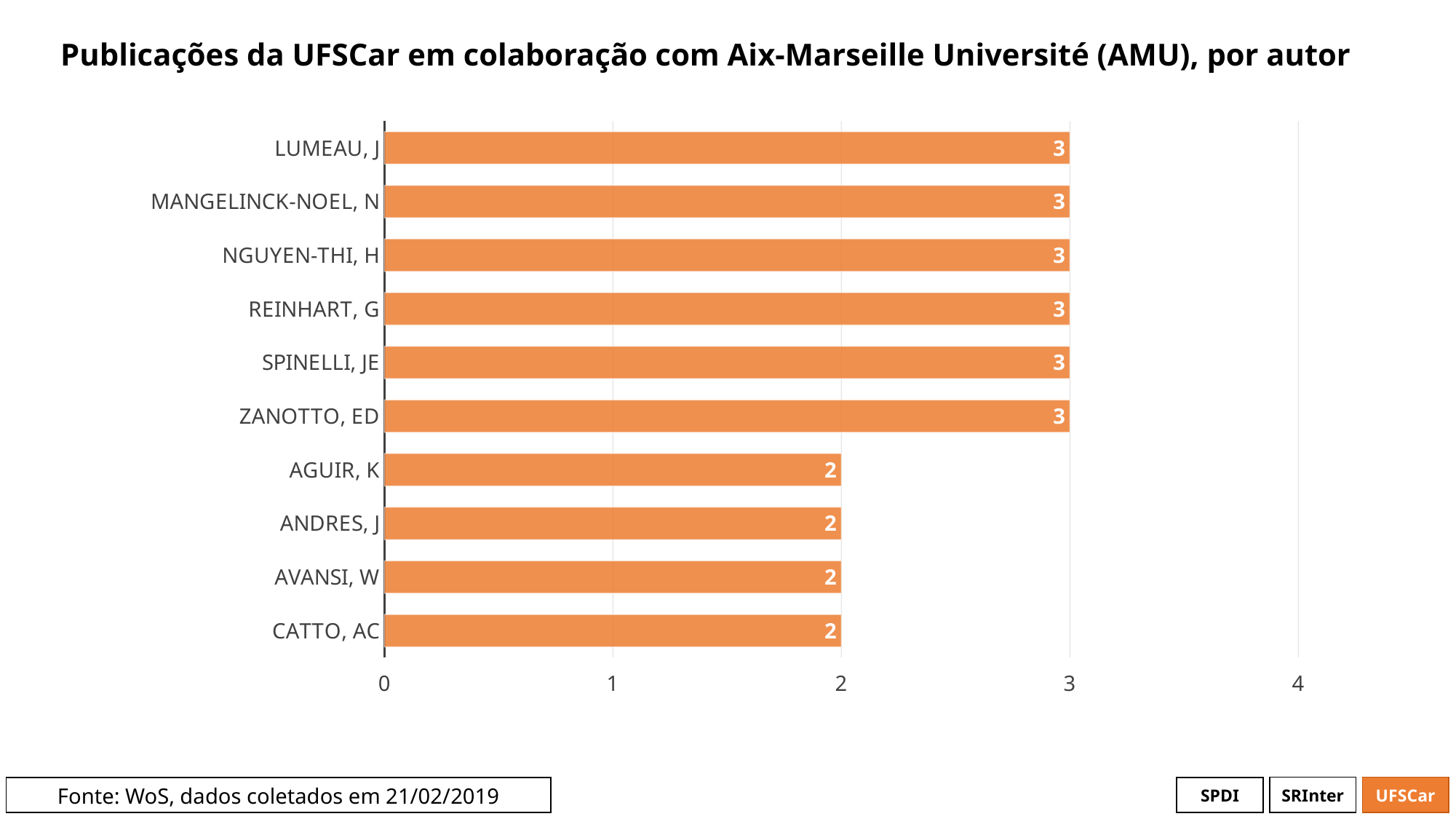
What is the source stated at the bottom of the slide? WoS, dados coletados em 21/02/2019 How many publications does LUMEAU, J have? 3 How many authors are shown in the chart? 10 What is the value for AGUIR, K? 2 Which has a larger value, SPINELLI, JE or AVANSI, W? SPINELLI, JE What is the value for ZANOTTO, ED? 3 What is the value for CATTO, AC? 2 How many authors have a value of 2? 4 How many authors have a value of 3? 6 What kind of chart is shown on the slide? bar chart What is the title of the chart? Publicações da UFSCar em colaboração com Aix-Marseille Université (AMU), por autor What is the difference between the values for REINHART, G and ANDRES, J? 1